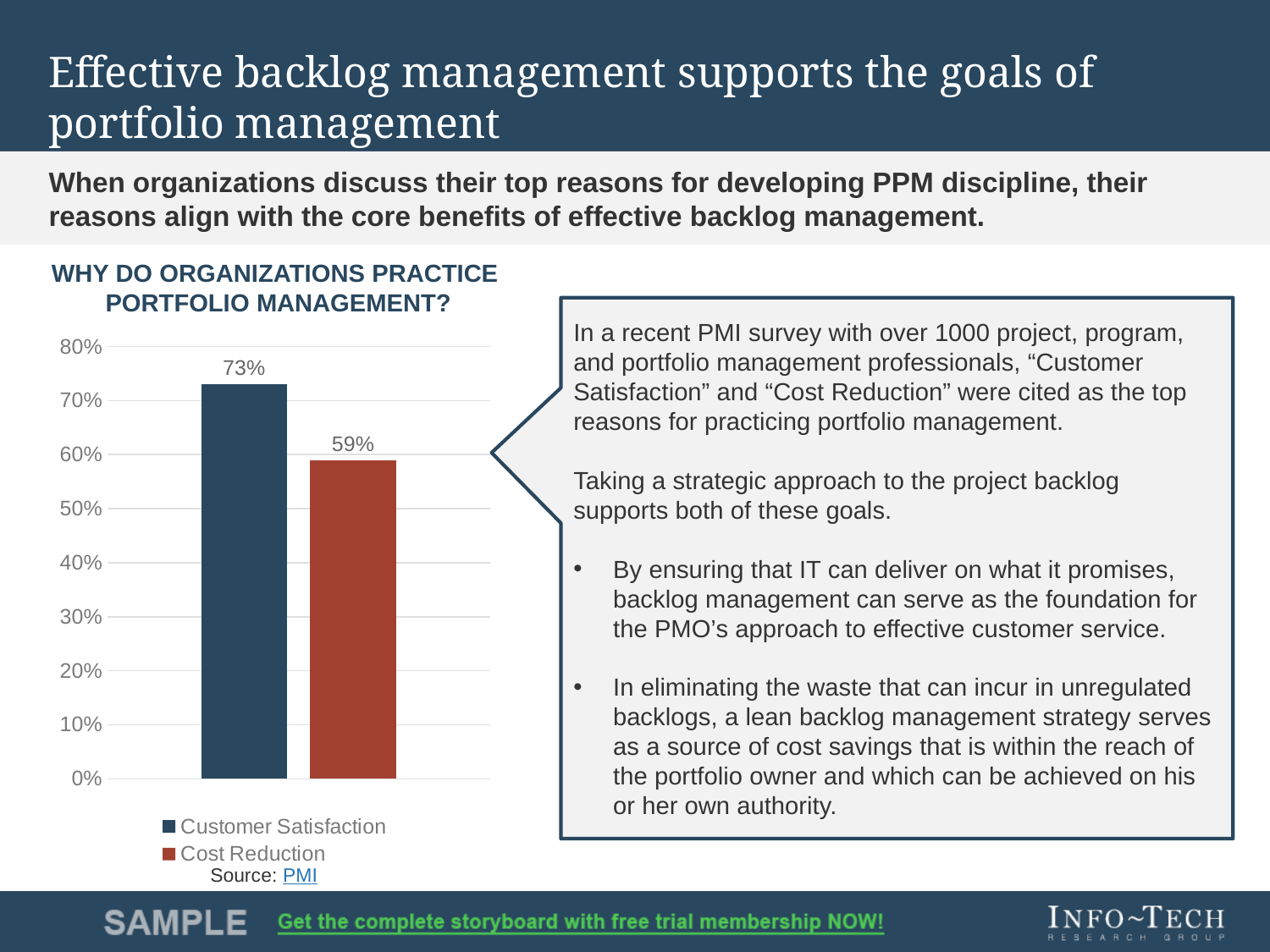
Is the value for Customer Satisfaction greater or less than 70%? greater What is the difference between the values for Customer Satisfaction and Cost Reduction? 14% Which category has the lowest value? Cost Reduction What is the title of the chart? WHY DO ORGANIZATIONS PRACTICE PORTFOLIO MANAGEMENT? How many bars are plotted in the chart? 2 How many entries does the legend list? 2 Is the value for Cost Reduction greater or less than 60%? less What kind of chart is shown on the slide? Bar chart What is the value for Customer Satisfaction? 73% Which is larger, the value for Customer Satisfaction or the value for Cost Reduction? Customer Satisfaction Which category has the highest value? Customer Satisfaction What is the value for Cost Reduction? 59%